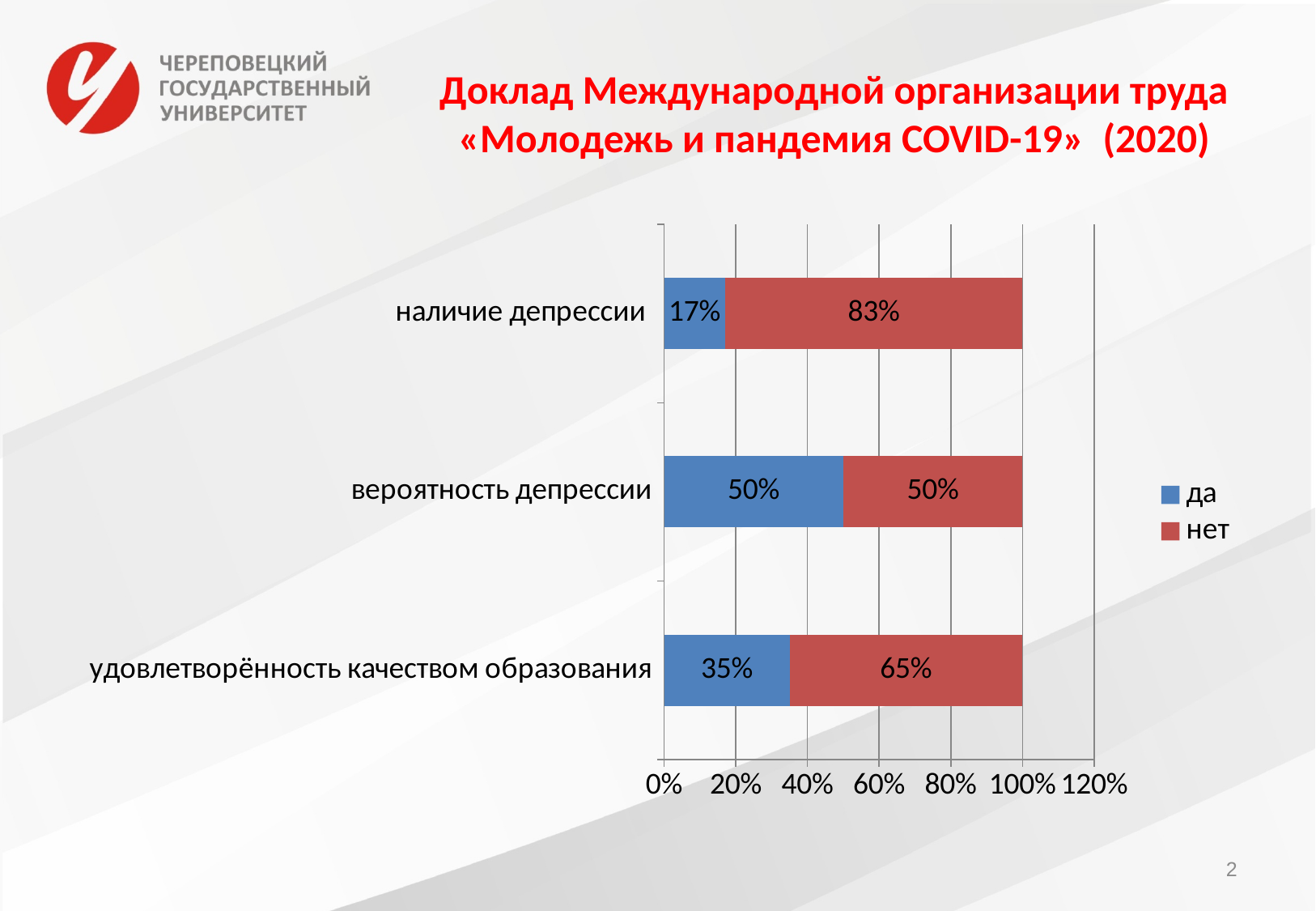
What is the difference between the "нет" and "да" values for "наличие депрессии"? 66% What kind of chart is shown on the slide? stacked bar chart What is the value of "нет" for "удовлетворённость качеством образования"? 65% Which category has the lowest "да" value? наличие депрессии How many categories are shown on the chart? 3 What is the total of the stacked bar for "вероятность депрессии"? 100% Which is larger for "удовлетворённость качеством образования": "да" or "нет"? нет Which category has the highest "да" value? вероятность депрессии What is the value of "да" for "вероятность депрессии"? 50% What is the value of "да" for "наличие депрессии"? 17% How many series does the legend list? 2 Which colour represents the "нет" series in the legend? red